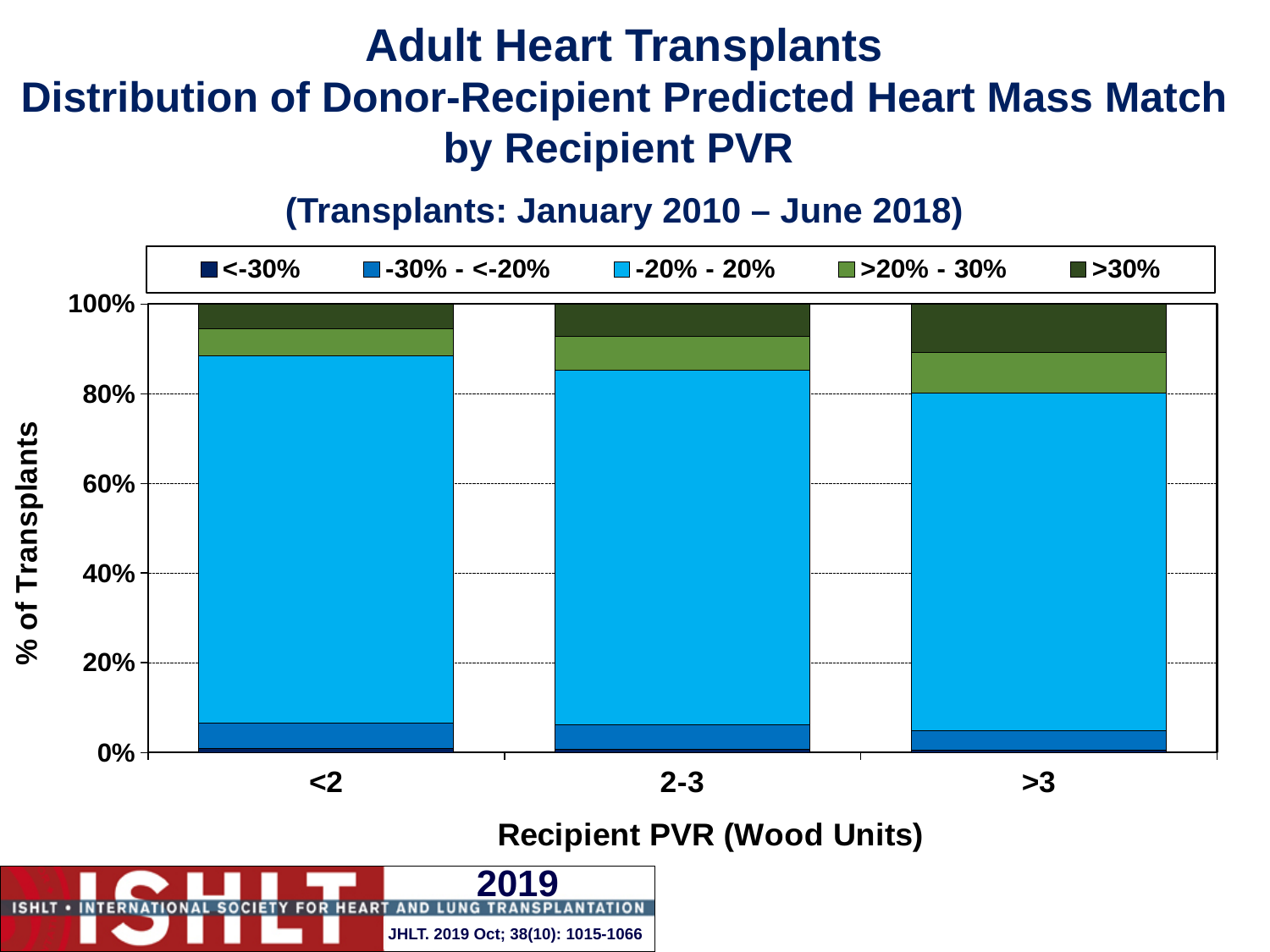
Is the top of the -20% - 20% segment for the <2 category greater or less than 80%? greater What is the total height of each stacked bar? 100% Which category has the larger -20% - 20% segment, <2 or >3? <2 How many series does the legend list? 5 Which category has the larger >30% segment, <2 or >3? >3 What is the label of the x axis? Recipient PVR (Wood Units) Does the share of the -20% - 20% segment rise or fall moving from <2 to >3 along the x axis? fall Is the top of the -20% - 20% segment for the 2-3 category greater or less than 80%? greater How many recipient PVR categories are shown on the x axis? 3 What is the label of the y axis? % of Transplants Is the top of the -30% - <-20% segment for the <2 category greater or less than 20%? less What kind of chart is shown on the slide? Stacked bar chart